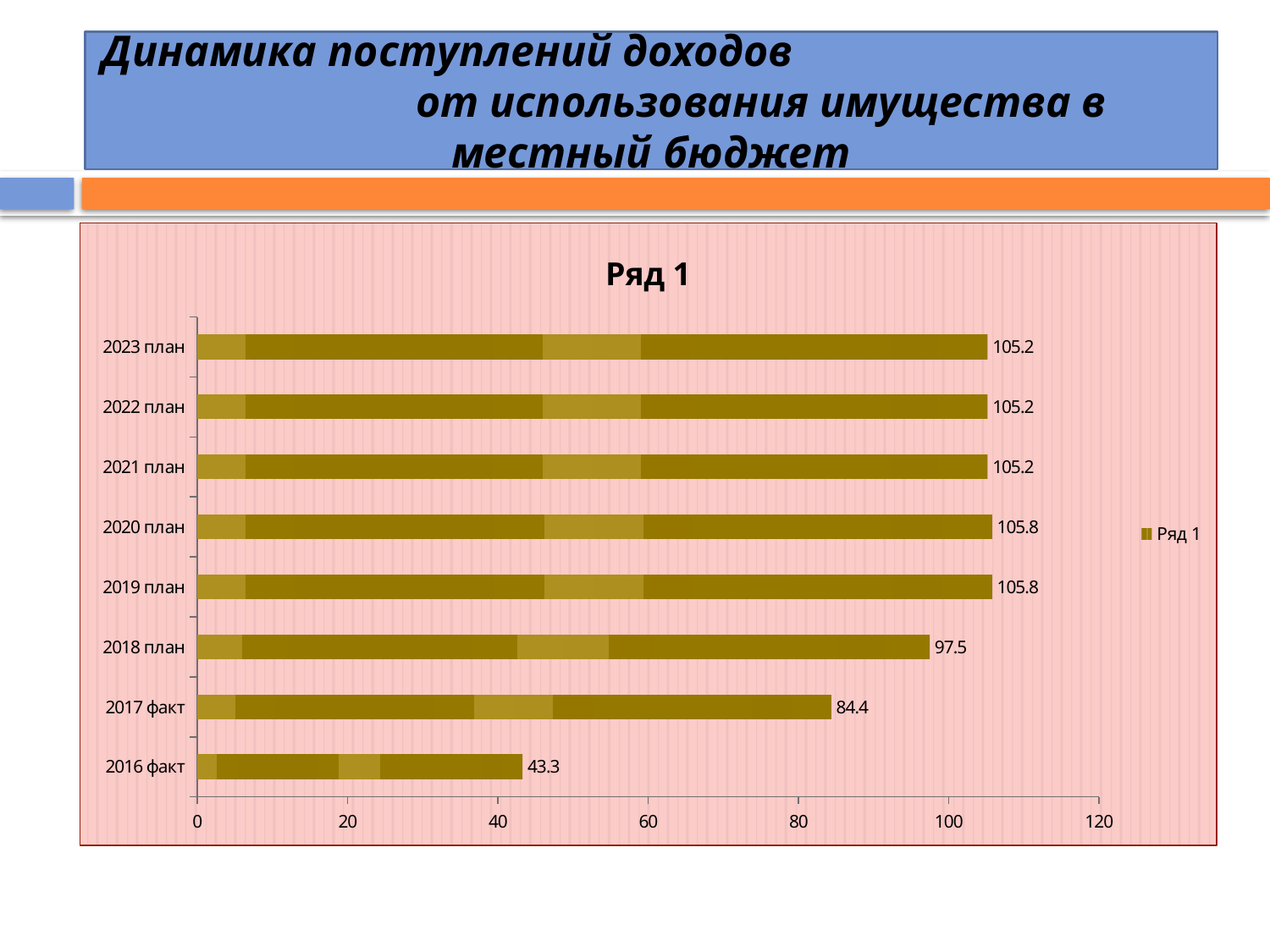
What is the value for 2020 план? 105.8 What is the title of the chart? Ряд 1 What is the difference between the values for 2019 план and 2018 план? 8.3 What kind of chart is shown on the slide? bar chart What is the value for 2016 факт? 43.3 What is the value for 2018 план? 97.5 What is the difference between the values for 2017 факт and 2016 факт? 41.1 Is the value for 2017 факт greater or less than 80? greater Which is larger, the value for 2018 план or the value for 2017 факт? 2018 план How many series does the legend list? 1 How many categories are shown on the chart? 8 Which category has the lowest value? 2016 факт